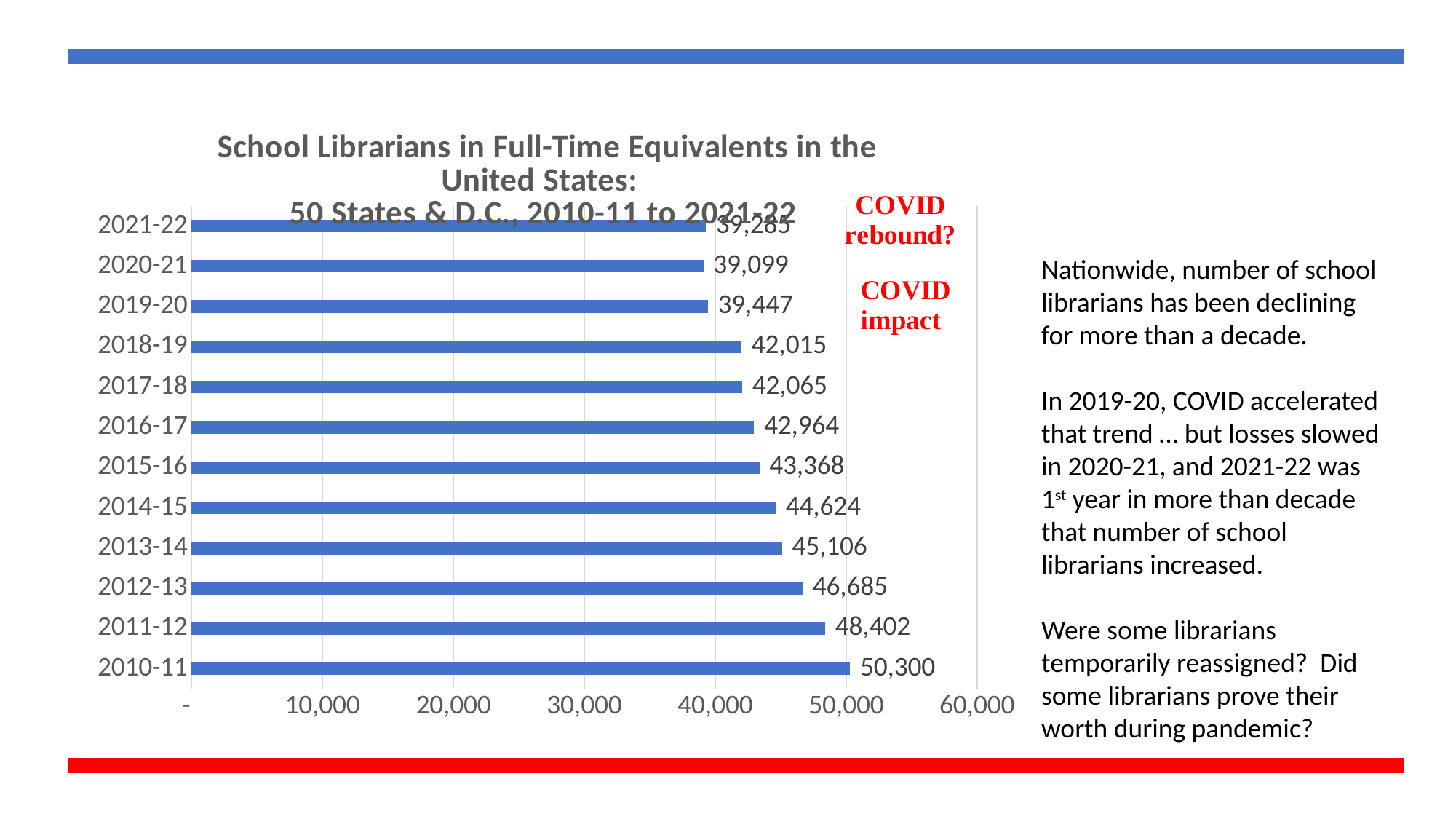
What is the value for 2014-15? 44,624 What is the value for 2010-11? 50,300 Is the value for 2021-22 greater or less than 40,000? less Do the values generally rise or fall from 2010-11 to 2020-21? fall What kind of chart is shown on the slide? bar chart How many school years are shown in the chart? 12 What is the difference between the values for 2010-11 and 2011-12? 1,898 What is the difference between the values for 2018-19 and 2019-20? 2,568 Which is larger, the value for 2012-13 or the value for 2015-16? 2012-13 What is the value for 2019-20? 39,447 Which school year has the highest number of school librarians in full-time equivalents? 2010-11 Which school year is labelled with the red annotation "COVID impact"? 2019-20